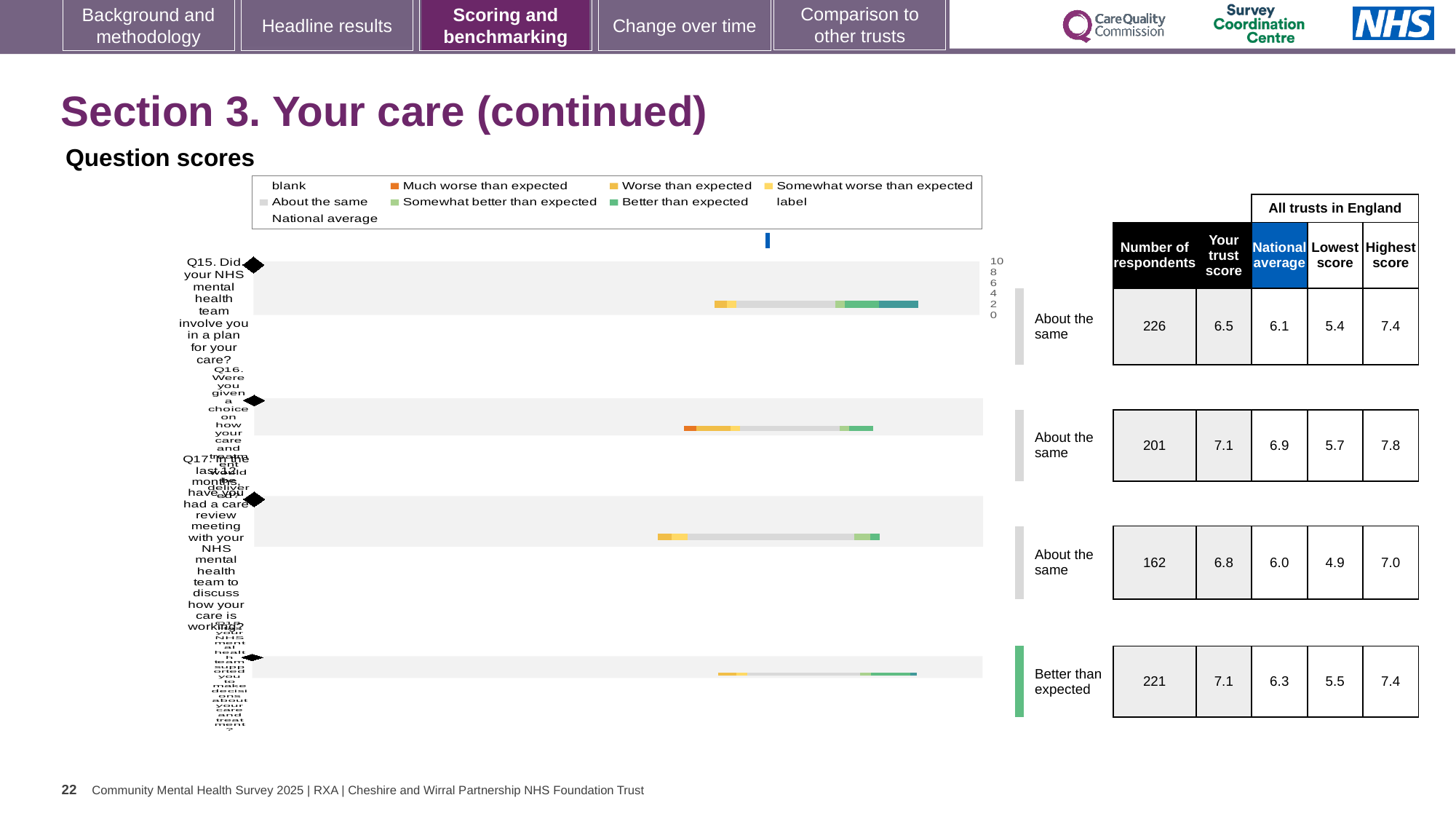
How many questions (bars) are plotted in the question scores chart? 4 What is the national average for Q17 (care review meeting in the last 12 months)? 6.0 What is the number of respondents for Q15 (involving you in a plan for your care)? 226 For Q16, is the trust score higher or lower than the national average? higher What is the difference between the highest and lowest scores in England for Q17? 2.1 Which question has the fewest respondents? Q17 What is the trust score for Q16 (given a choice on how your care and treatment would be delivered)? 7.1 What is the highest score among all trusts in England for Q16? 7.8 What kind of chart is used to show the question scores on this slide? bar chart How many of the questions on this slide are rated 'About the same'? 3 Which question has the most respondents? Q15 What is the difference between the trust score and the national average for Q15? 0.4